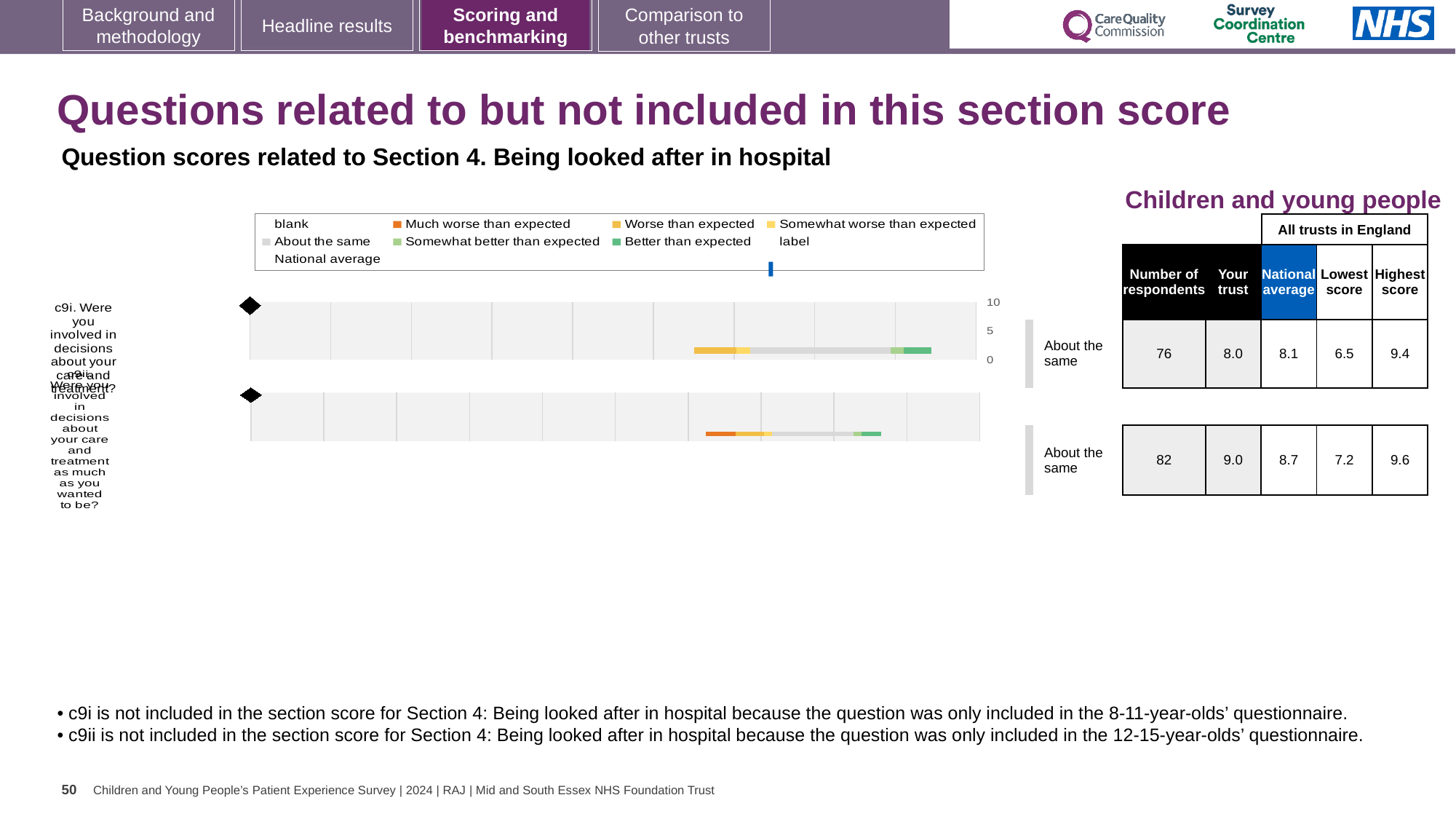
In the table beside the chart, what is the national average for c9ii? 8.7 In the table beside the chart, what is the 'Your trust' score for c9i? 8.0 Which question has the higher 'Your trust' score, c9i or c9ii? c9ii What is the difference between the highest score and the lowest score for c9i in the table beside the chart? 2.9 What colour represents 'Much worse than expected' in the chart legend? orange Which question has more respondents, c9i or c9ii? c9ii What is the highest value shown on the chart's numeric axis? 10 In the table beside the chart, how many respondents answered c9i? 76 What kind of chart is used to show the question scores for c9i and c9ii? bar chart What benchmark category is shown next to the bar for c9ii? About the same In the table beside the chart, what is the lowest score across all trusts in England for c9ii? 7.2 How many questions (bars) are plotted in the chart? 2